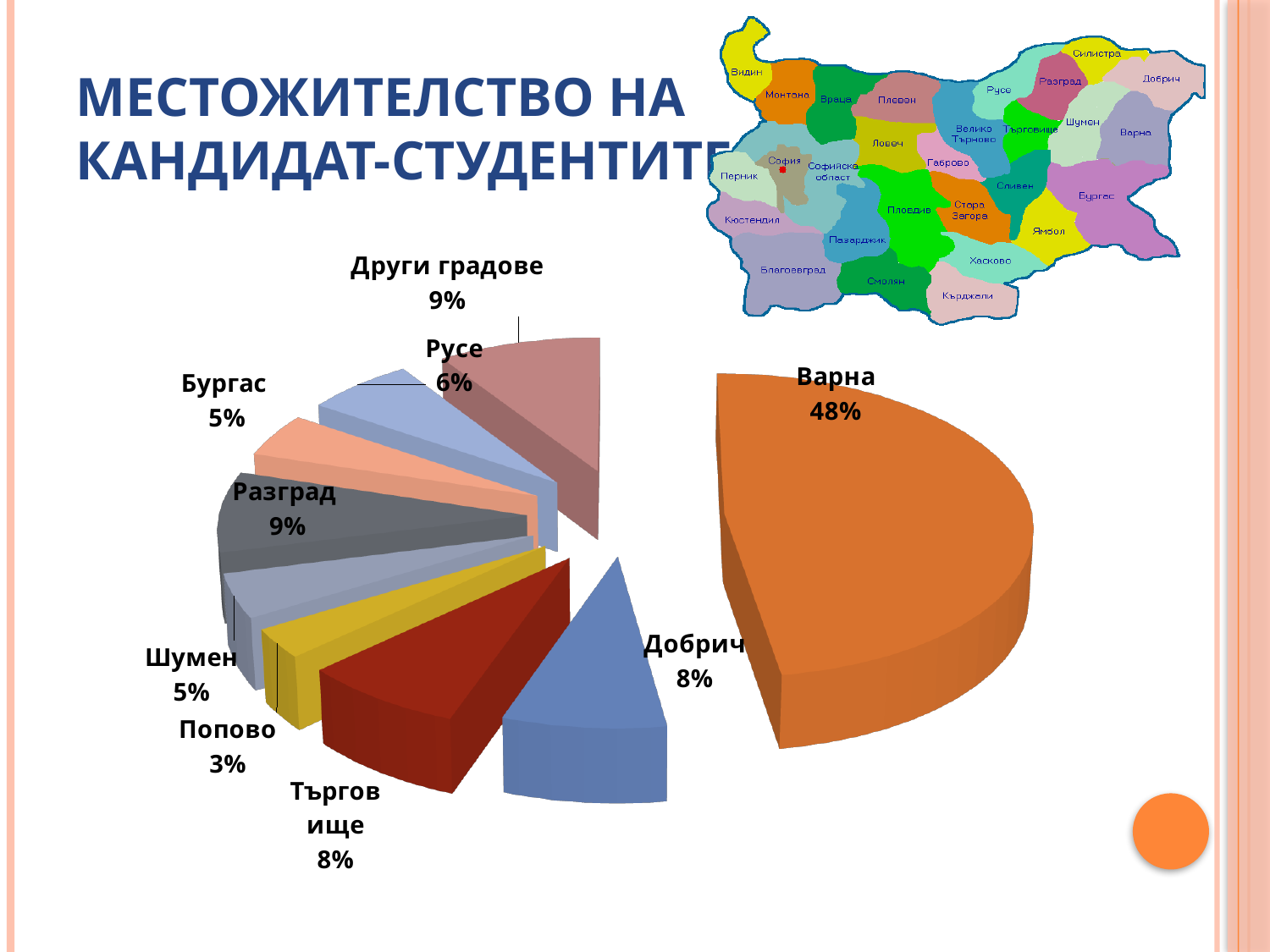
What is the value shown for Търговище? 8% Which category has the largest slice of the pie? Варна What is the difference between the values for Разград and Бургас? 4% What is the difference between the values for Варна and Добрич? 40% Which is larger, the value for Русе or the value for Шумен? Русе How many slices does the pie chart have? 9 What is the value shown for Русе? 6% What is the title of the slide containing the chart? МЕСТОЖИТЕЛСТВО НА КАНДИДАТ-СТУДЕНТИТЕ Which category has the smallest slice of the pie? Попово What share of the pie does Варна have? 48% What is the value shown for Попово? 3% What kind of chart is shown on the slide? Pie chart